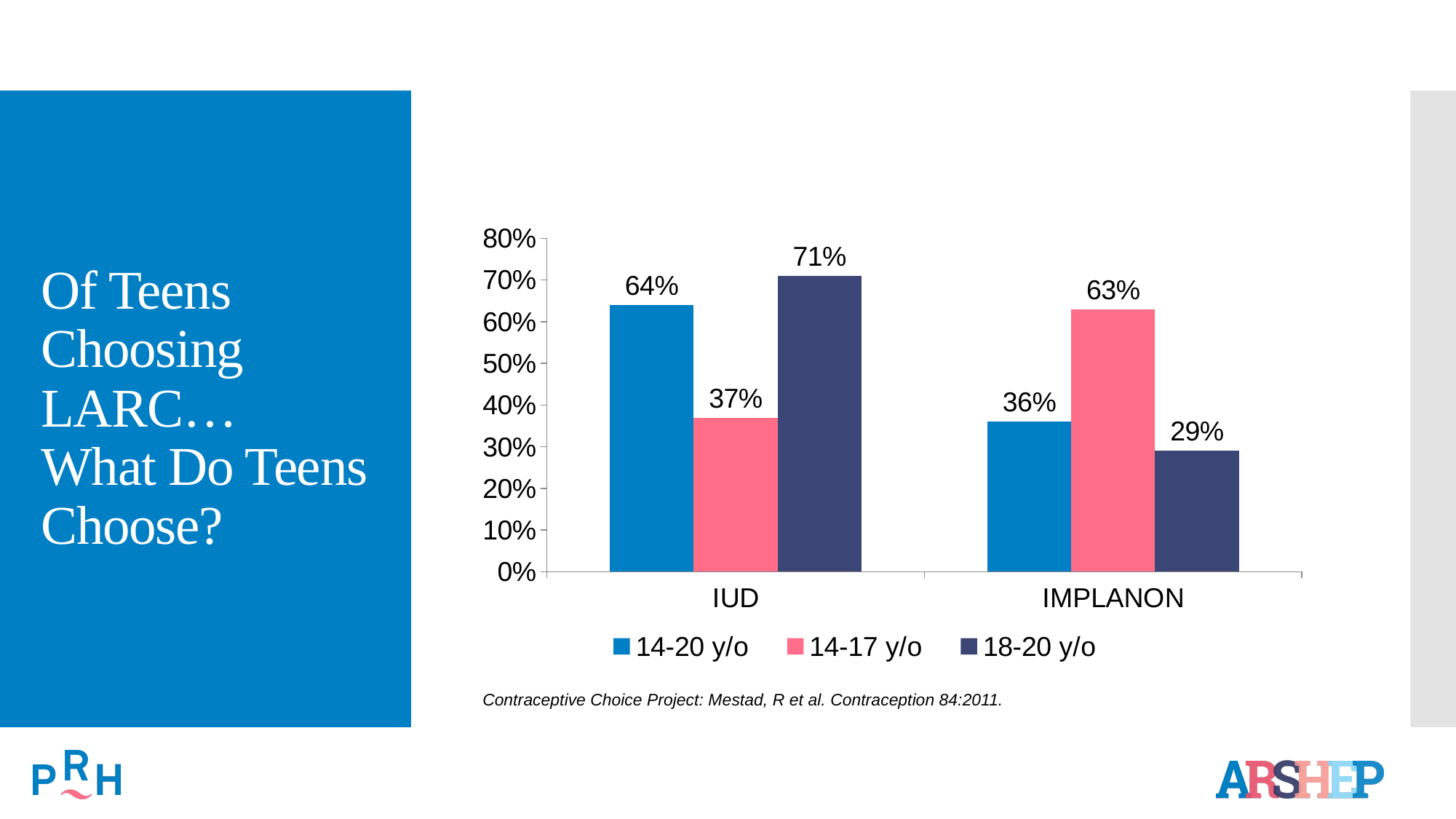
What percentage of 14-17 year olds chose IMPLANON? 63% Which age group has the lowest value for IMPLANON? 18-20 y/o Which age group has the highest value for IUD? 18-20 y/o What kind of chart is shown on the slide? Bar chart Is the 14-17 y/o value for IUD greater or less than 40%? less Which colour represents the 14-17 y/o series in the legend? Pink How many series does the legend list? 3 What percentage of 18-20 year olds chose IMPLANON? 29% Which is larger: the 14-20 y/o value for IUD or the 14-20 y/o value for IMPLANON? IUD How many categories are shown on the x axis? 2 What is the difference between the 18-20 y/o value for IUD and the 14-17 y/o value for IUD? 34% What percentage of 14-20 year olds chose IUD? 64%